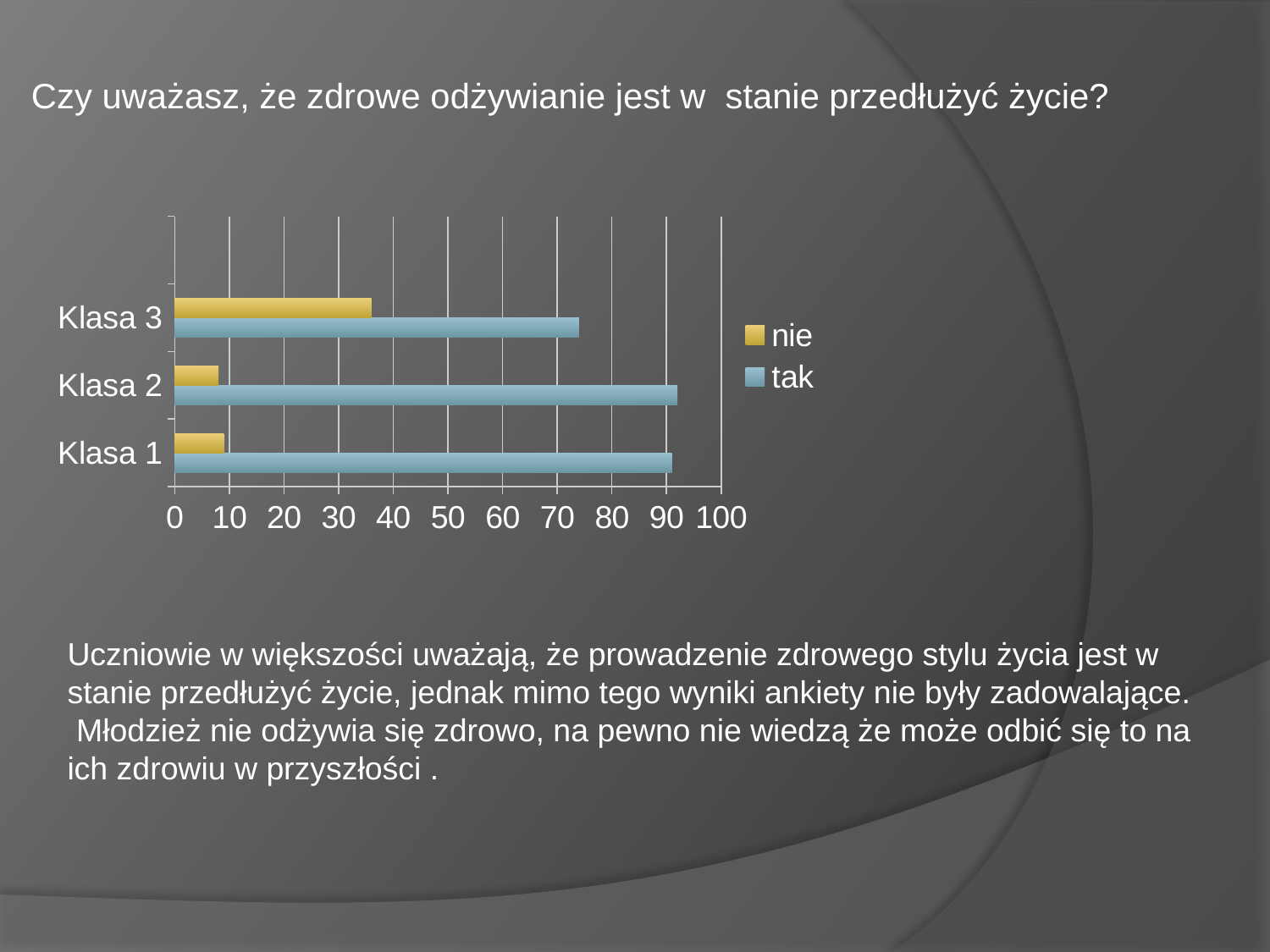
What is the maximum value shown on the horizontal axis? 100 Which class has the lowest value for "tak"? Klasa 3 Is the value for "nie" in Klasa 2 greater or less than 20? less For Klasa 1, which is larger: the value for "tak" or the value for "nie"? tak How many categories (classes) are shown on the chart? 3 Which colour represents the "nie" series in the legend? yellow What kind of chart is shown on the slide? bar chart Is the value for "tak" in Klasa 3 greater or less than 60? greater How many series does the legend list? 2 Which class has the highest value for "nie"? Klasa 3 Is the value for "nie" in Klasa 3 greater or less than 30? greater